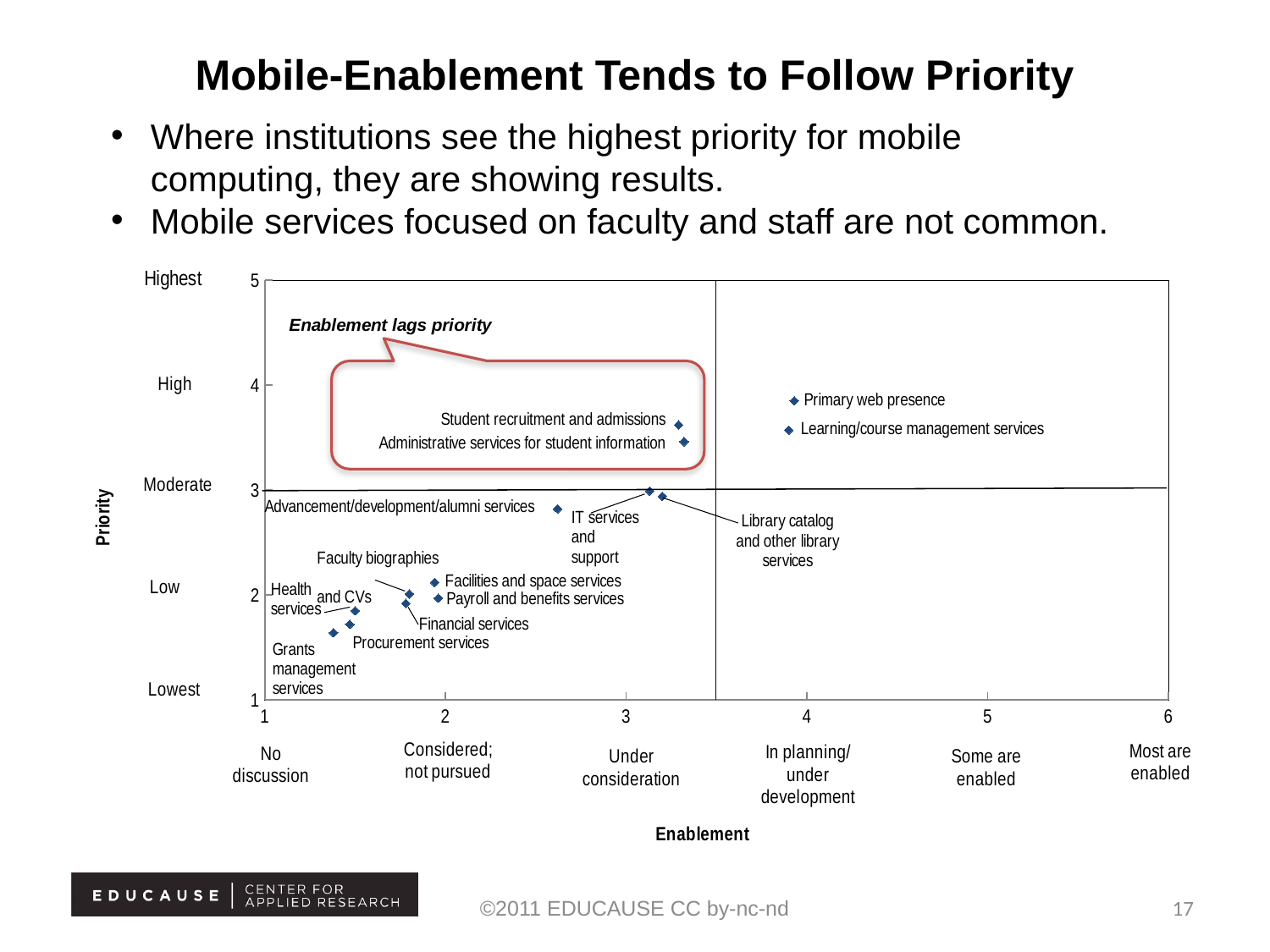
Is the Enablement value for Learning/course management services greater or less than 3? greater Is the Priority value for Student recruitment and admissions greater or less than 3? greater Is the Priority value for Primary web presence greater or less than 3? greater Which has a higher Enablement value, Primary web presence or Student recruitment and admissions? Primary web presence How many labeled data points are plotted on the chart? 14 What text appears in the callout box inside the chart? Enablement lags priority What kind of chart is shown on the slide? Scatter chart Which has a higher Priority value, Facilities and space services or Grants management services? Facilities and space services What is the title of the horizontal axis of the chart? Enablement Which service has the highest Priority value on the chart? Primary web presence